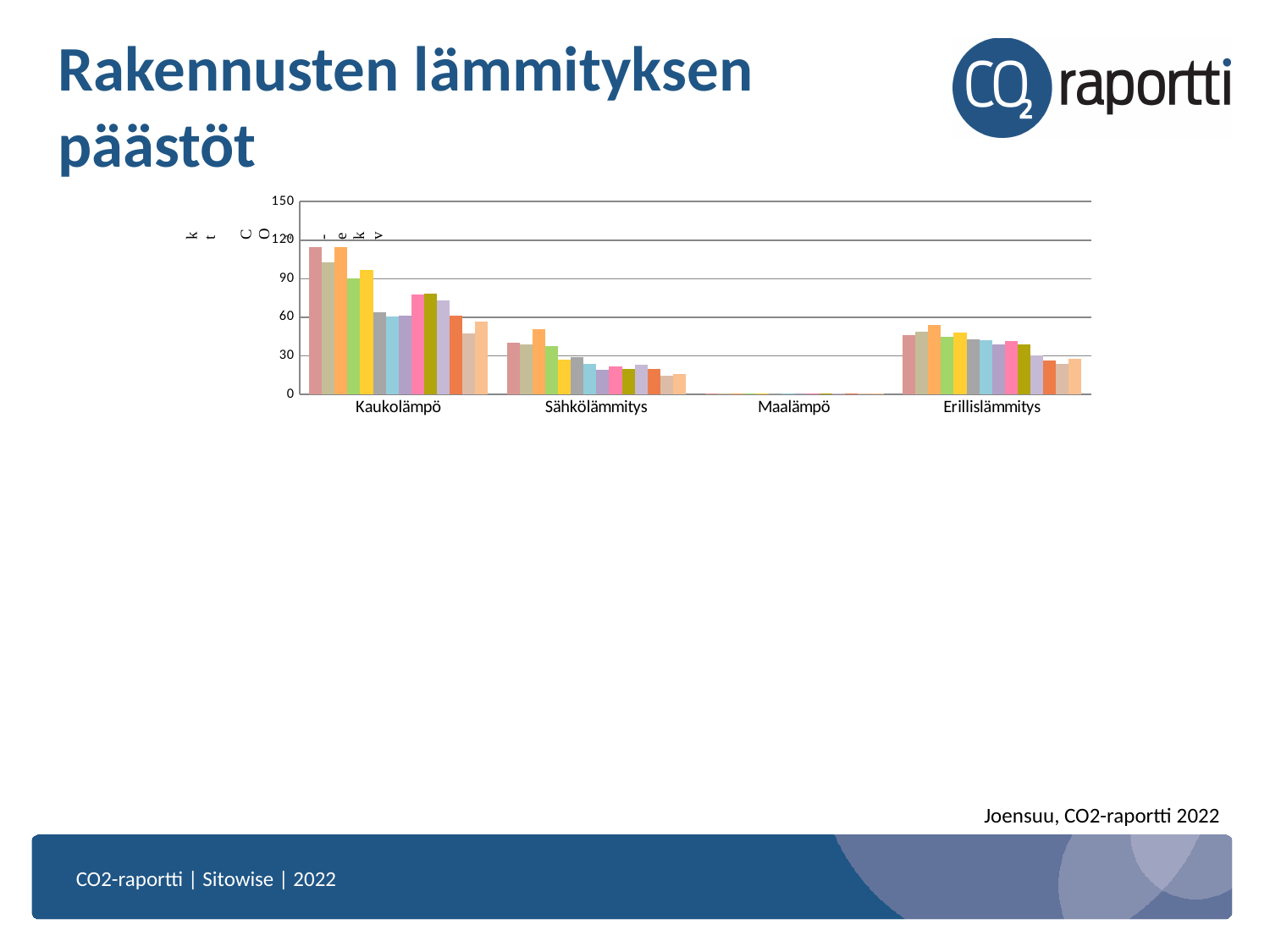
Is the tallest bar for Erillislämmitys greater or less than 90? less Which heating category has the lowest emissions? Maalämpö Which heating category has the highest emissions? Kaukolämpö Is the tallest bar for Sähkölämmitys greater or less than 60? less Are the bars for Maalämpö greater or less than 30? less What kind of chart is shown on the slide? bar chart What is the title of the slide containing the chart? Rakennusten lämmityksen päästöt Which category has larger emissions, Kaukolämpö or Sähkölämmitys? Kaukolämpö How many heating categories are shown on the x axis? 4 What is the highest value shown on the y axis? 150 Which category has larger emissions, Erillislämmitys or Maalämpö? Erillislämmitys